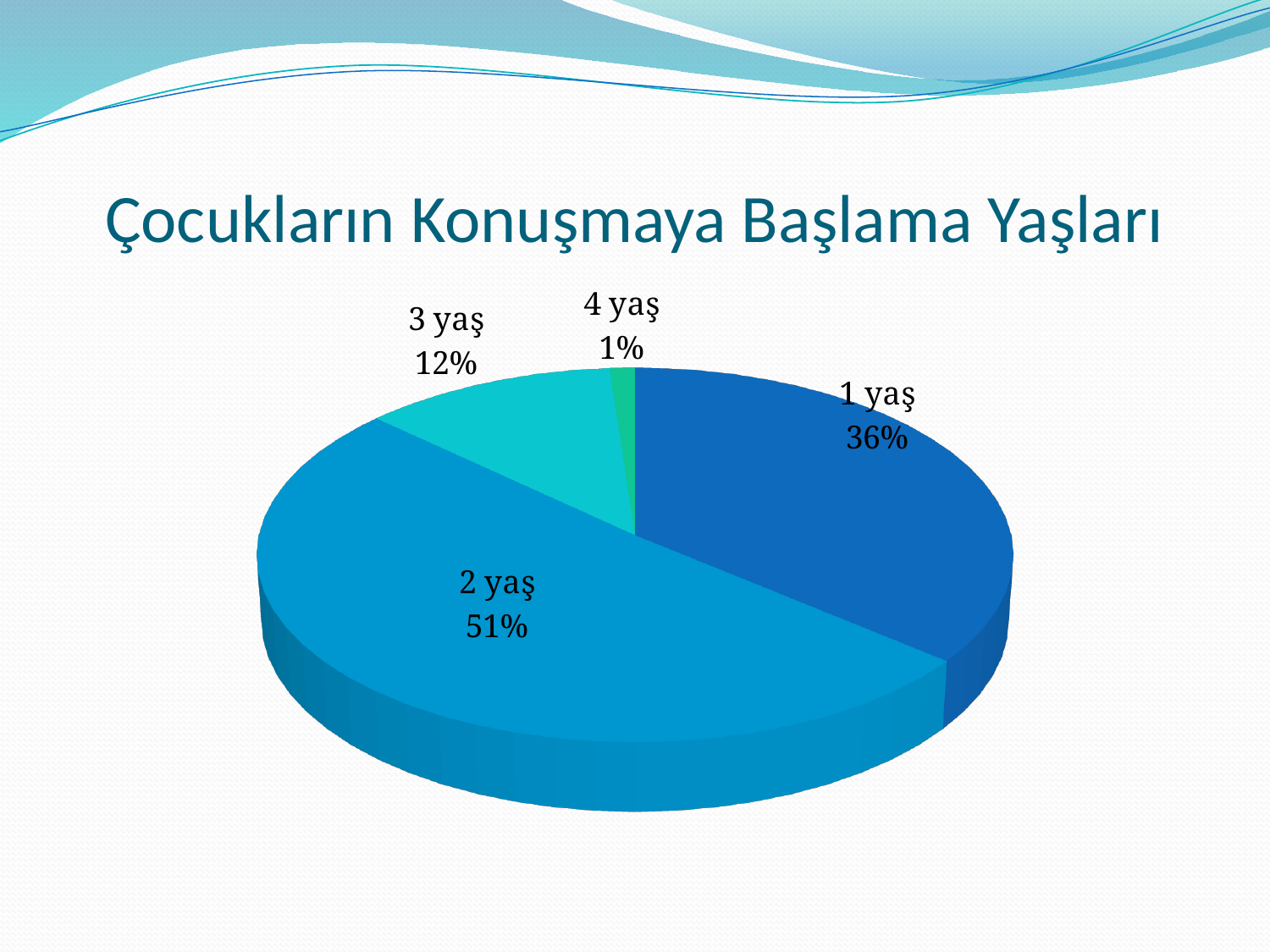
What kind of chart is shown on the slide? Pie chart What share of the pie does the "2 yaş" slice represent? 51% Which category has the largest slice of the pie? 2 yaş What is the difference in percentage points between the "2 yaş" and "1 yaş" slices? 15 Which slice is larger, "1 yaş" or "3 yaş"? 1 yaş Which category has the smallest slice of the pie? 4 yaş What share of the pie does the "3 yaş" slice represent? 12% What share of the pie does the "1 yaş" slice represent? 36% What is the title of the slide containing the chart? Çocukların Konuşmaya Başlama Yaşları How many categories are shown in the pie chart? 4 What is the difference in percentage points between the "3 yaş" and "4 yaş" slices? 11